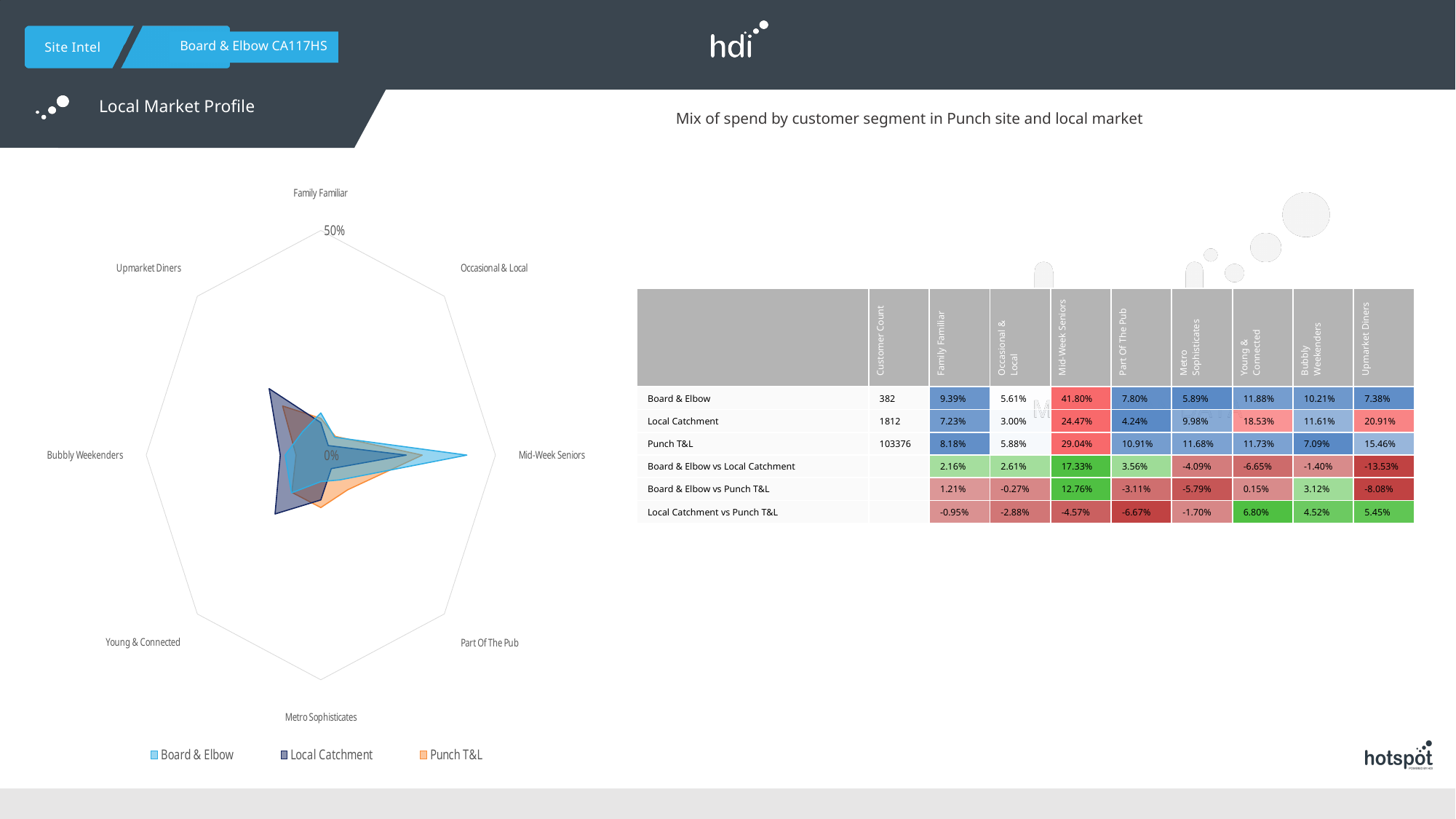
Which series are listed in the radar chart's legend? Board & Elbow, Local Catchment, Punch T&L How many customer segments (axes) does the radar chart have? 8 According to the table, what is the Board & Elbow share of spend for Mid-Week Seniors? 41.80% For the Punch T&L series, which customer segment has the highest share of spend? Mid-Week Seniors How many series does the radar chart's legend list? 3 For Upmarket Diners, which is larger: the Local Catchment value or the Board & Elbow value? Local Catchment For the Board & Elbow series, which customer segment has the highest share of spend? Mid-Week Seniors What kind of chart is shown on the left of the slide? Radar chart For Mid-Week Seniors, which is larger: the Board & Elbow value or the Local Catchment value? Board & Elbow What is the maximum value shown on the radar chart's axis scale? 50% According to the table, what is the Local Catchment share of spend for Upmarket Diners? 20.91% Is the Board & Elbow value for Mid-Week Seniors greater or less than 50%? less